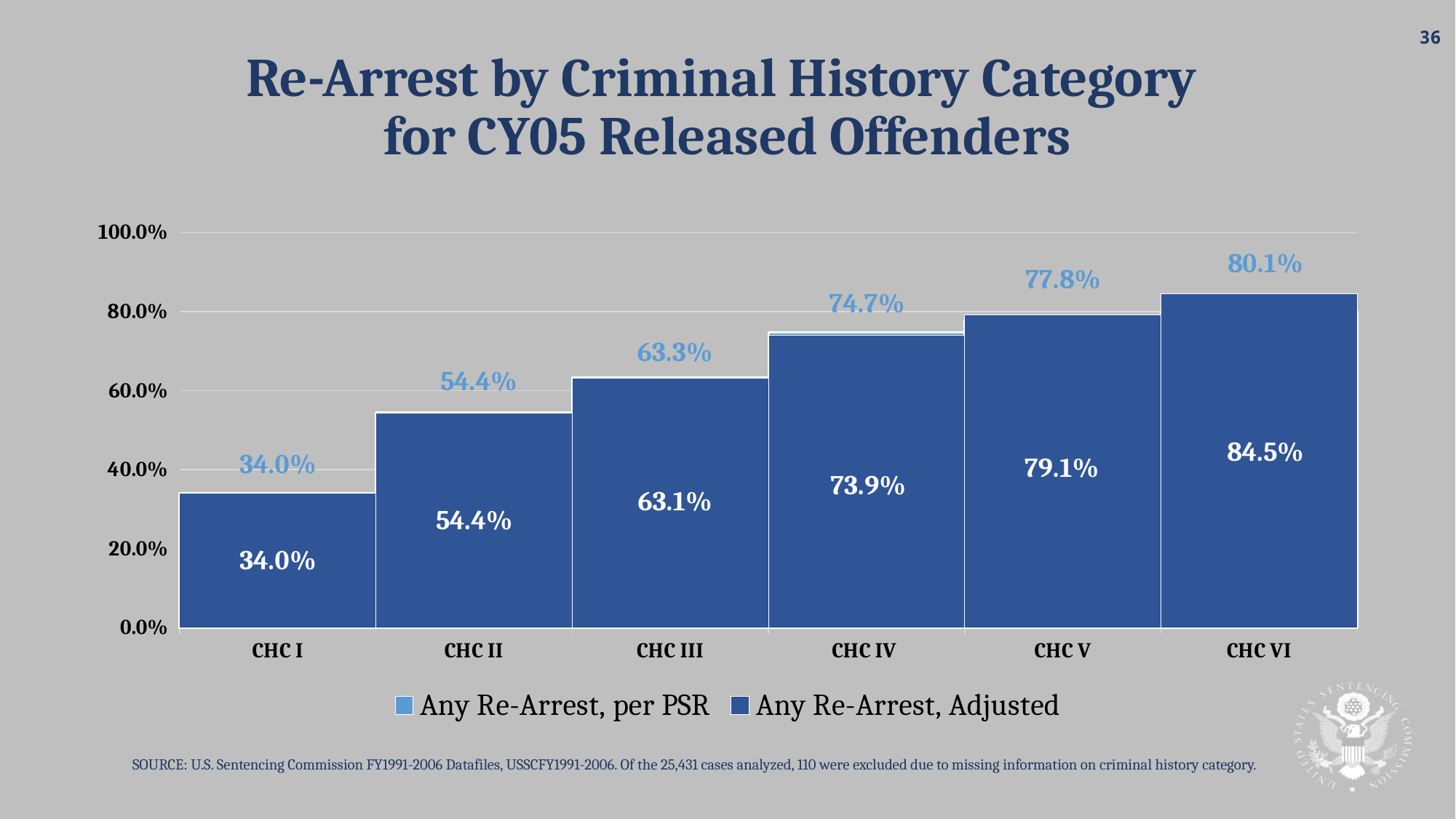
What is the Any Re-Arrest, Adjusted value for CHC III? 63.1% What is the difference between the Any Re-Arrest, Adjusted values for CHC VI and CHC I? 50.5% What is the difference between the Any Re-Arrest, per PSR and Any Re-Arrest, Adjusted values for CHC V? 1.3% How many criminal history categories are shown on the x axis? 6 How many series does the legend list? 2 What is the Any Re-Arrest, Adjusted value for CHC VI? 84.5% What is the Any Re-Arrest, per PSR value for CHC IV? 74.7% Do the Any Re-Arrest, Adjusted values rise or fall from CHC I to CHC VI? Rise Which is larger for CHC VI: the Any Re-Arrest, per PSR value or the Any Re-Arrest, Adjusted value? Any Re-Arrest, Adjusted Which criminal history category has the lowest Any Re-Arrest, per PSR value? CHC I What kind of chart is shown on the slide? Bar chart Which criminal history category has the highest Any Re-Arrest, Adjusted value? CHC VI